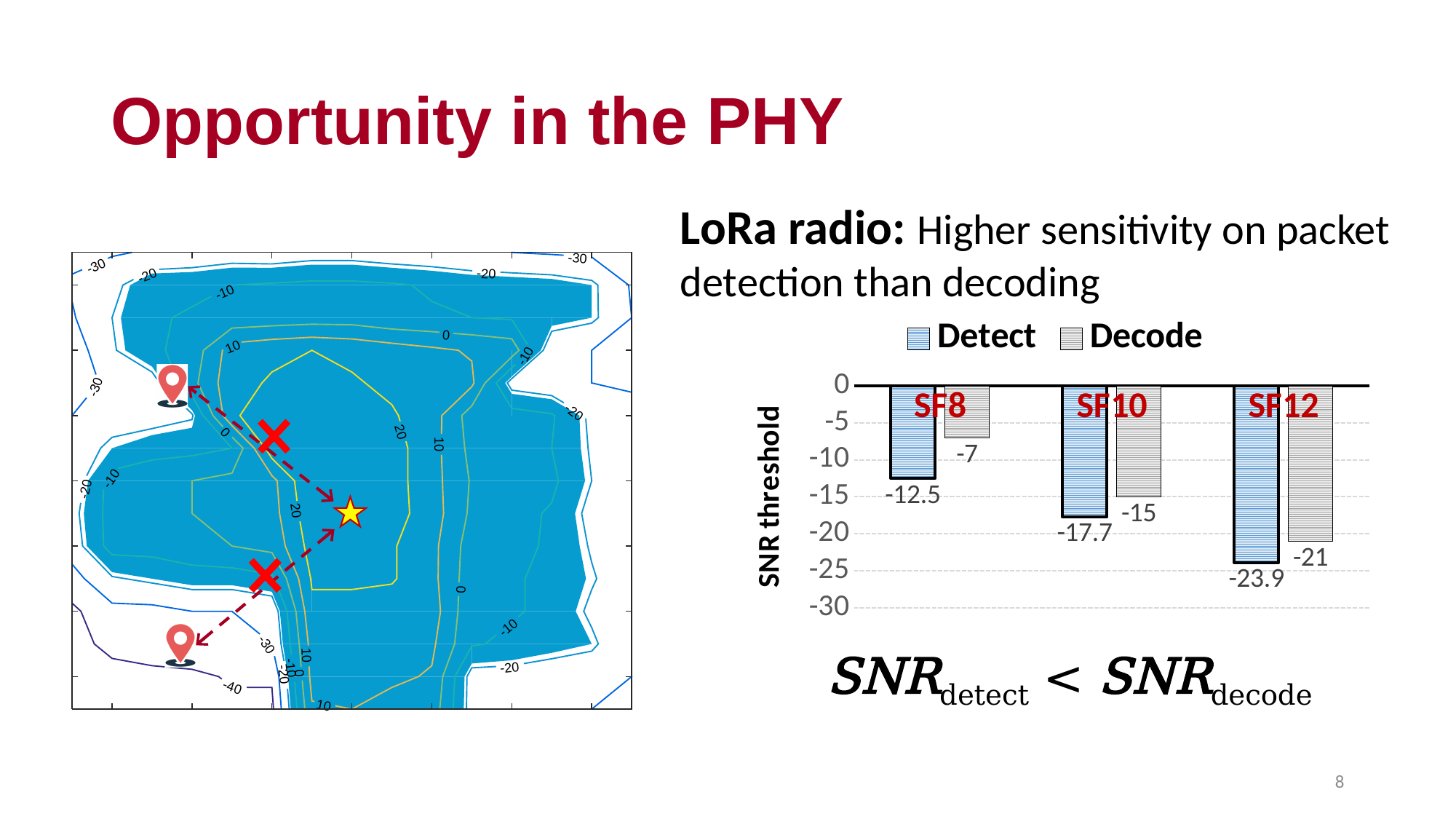
In the bar chart on the right, which spreading factor has the highest Decode SNR threshold? SF8 In the bar chart on the right, which spreading factor has the lowest Detect SNR threshold? SF12 In the bar chart on the right, what is the Detect SNR threshold for SF12? -23.9 In the bar chart on the right, what is the Detect SNR threshold for SF8? -12.5 In the bar chart on the right, for SF8, which is lower: the Detect or the Decode SNR threshold? Detect In the bar chart on the right, do the Detect SNR thresholds rise or fall from SF8 to SF12? Fall What kind of chart is shown on the right side of the slide? Bar chart How many spreading factor categories are shown in the bar chart on the right? 3 In the bar chart on the right, what is the Decode SNR threshold for SF10? -15 How many series does the legend of the bar chart on the right list? 2 In the bar chart on the right, what is the Decode SNR threshold for SF8? -7 In the bar chart on the right, what is the difference between the Decode and Detect SNR thresholds for SF12? 2.9